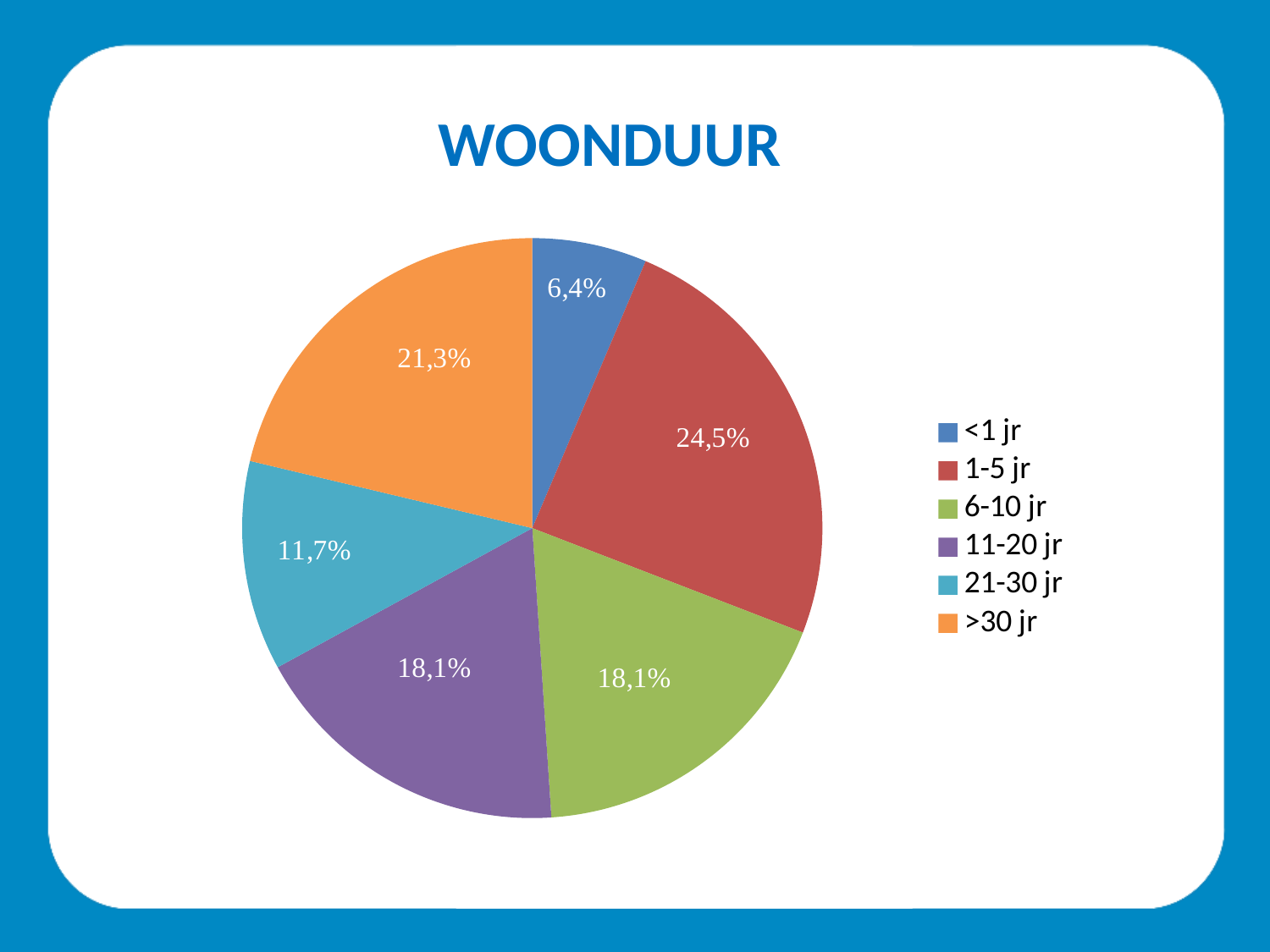
How many categories does the legend list? 6 What is the title of the chart? WOONDUUR What share of the pie does the "1-5 jr" slice represent? 24,5% What is the value shown for the ">30 jr" category? 21,3% What colour is the slice for "6-10 jr"? green What is the value shown for the "<1 jr" category? 6,4% Which is larger, the share for "21-30 jr" or the share for "11-20 jr"? 11-20 jr Which category has the smallest share of the pie? <1 jr What type of chart is shown on the slide? pie chart What is the difference between the shares of "1-5 jr" and ">30 jr"? 3,2% Which category has the largest share of the pie? 1-5 jr What is the value shown for the "21-30 jr" category? 11,7%